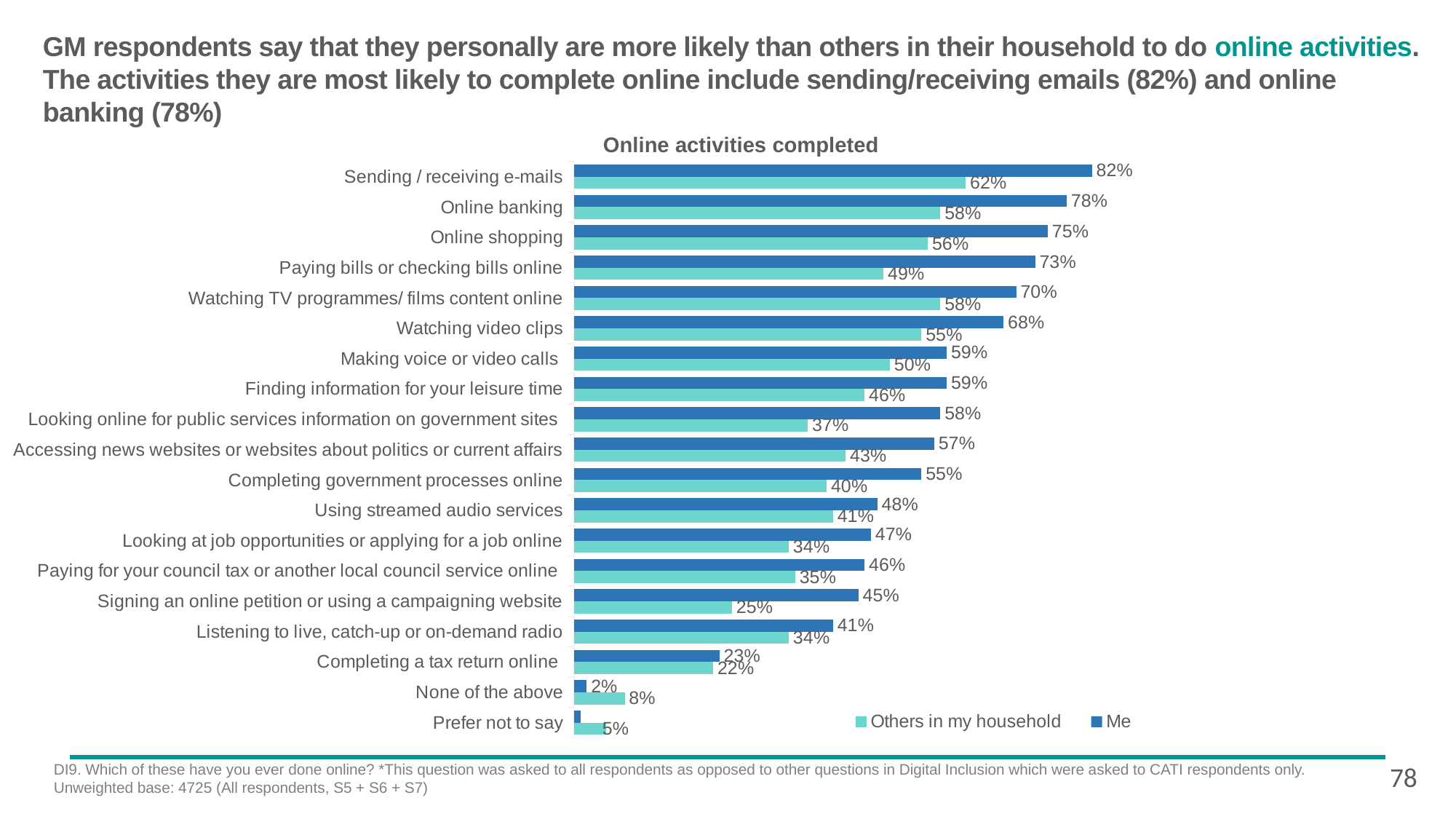
What is the title of the chart? Online activities completed Which category has the lowest value for "Others in my household"? Prefer not to say Which is larger: the "Me" value for Online shopping or the "Me" value for Watching video clips? Online shopping How many series does the legend list? 2 How many activity categories are shown on the chart? 19 What is the value for "Others in my household" for Online banking? 58% What is the difference between the "Me" and "Others in my household" values for Paying bills or checking bills online? 24 percentage points For None of the above, which is larger: the value for "Me" or for "Others in my household"? Others in my household Which activity has the highest value for "Me"? Sending / receiving e-mails What is the value for "Others in my household" for Signing an online petition or using a campaigning website? 25% What type of chart is shown? Bar chart What is the value for "Me" for Sending / receiving e-mails? 82%